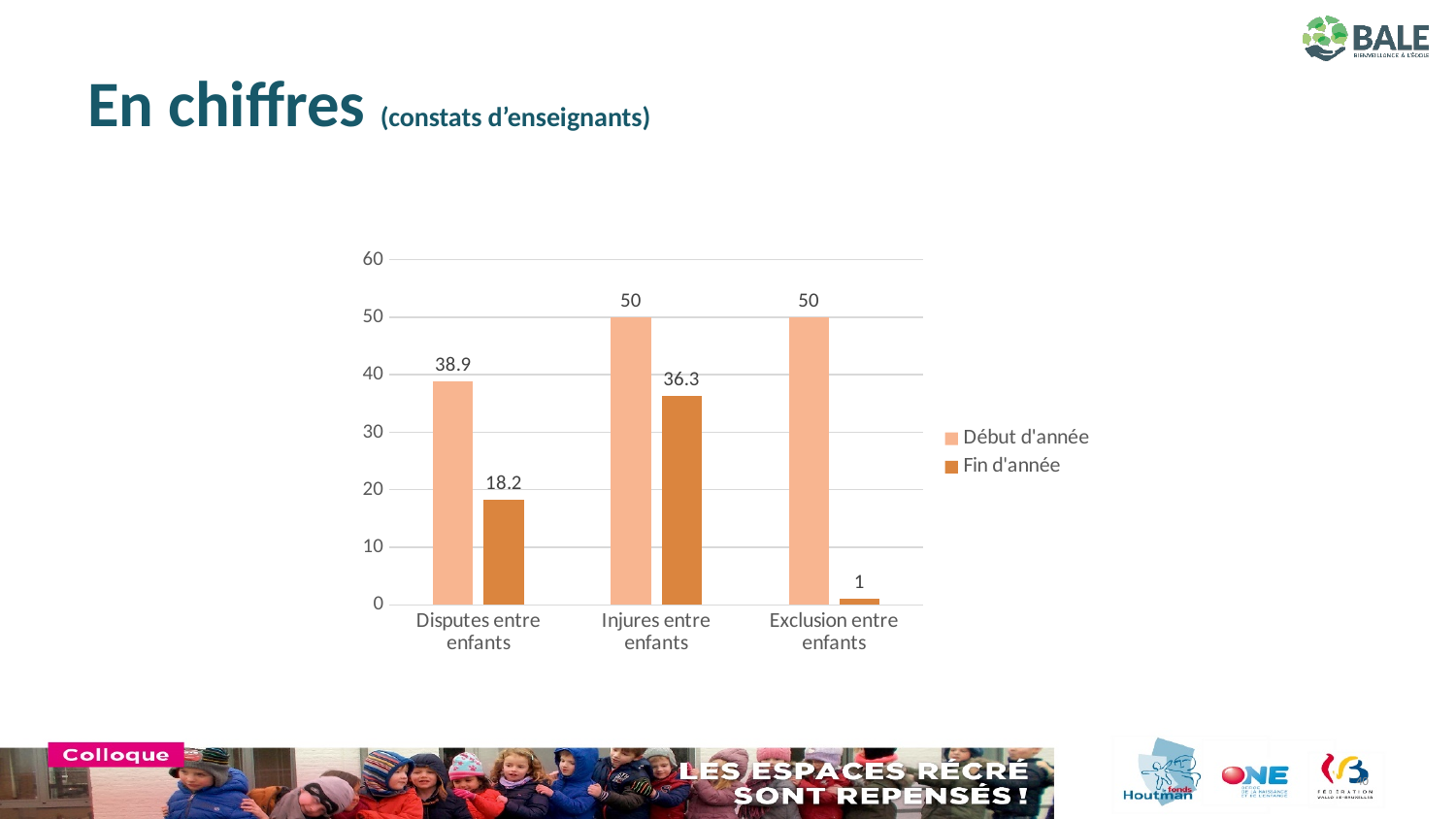
What is the difference between the Début d'année and Fin d'année values for Disputes entre enfants? 20.7 Which category has the highest Fin d'année value? Injures entre enfants What is the value for Fin d'année for Exclusion entre enfants? 1 Which category has the lowest Début d'année value? Disputes entre enfants Which is larger: the Fin d'année value for Disputes entre enfants or the Fin d'année value for Injures entre enfants? Injures entre enfants What is the value for Début d'année for Disputes entre enfants? 38.9 How many series does the legend list? 2 What kind of chart is shown on the slide? Bar chart What is the value for Fin d'année for Injures entre enfants? 36.3 What is the difference between the Début d'année and Fin d'année values for Exclusion entre enfants? 49 What is the value for Début d'année for Exclusion entre enfants? 50 Which category has the lowest Fin d'année value? Exclusion entre enfants